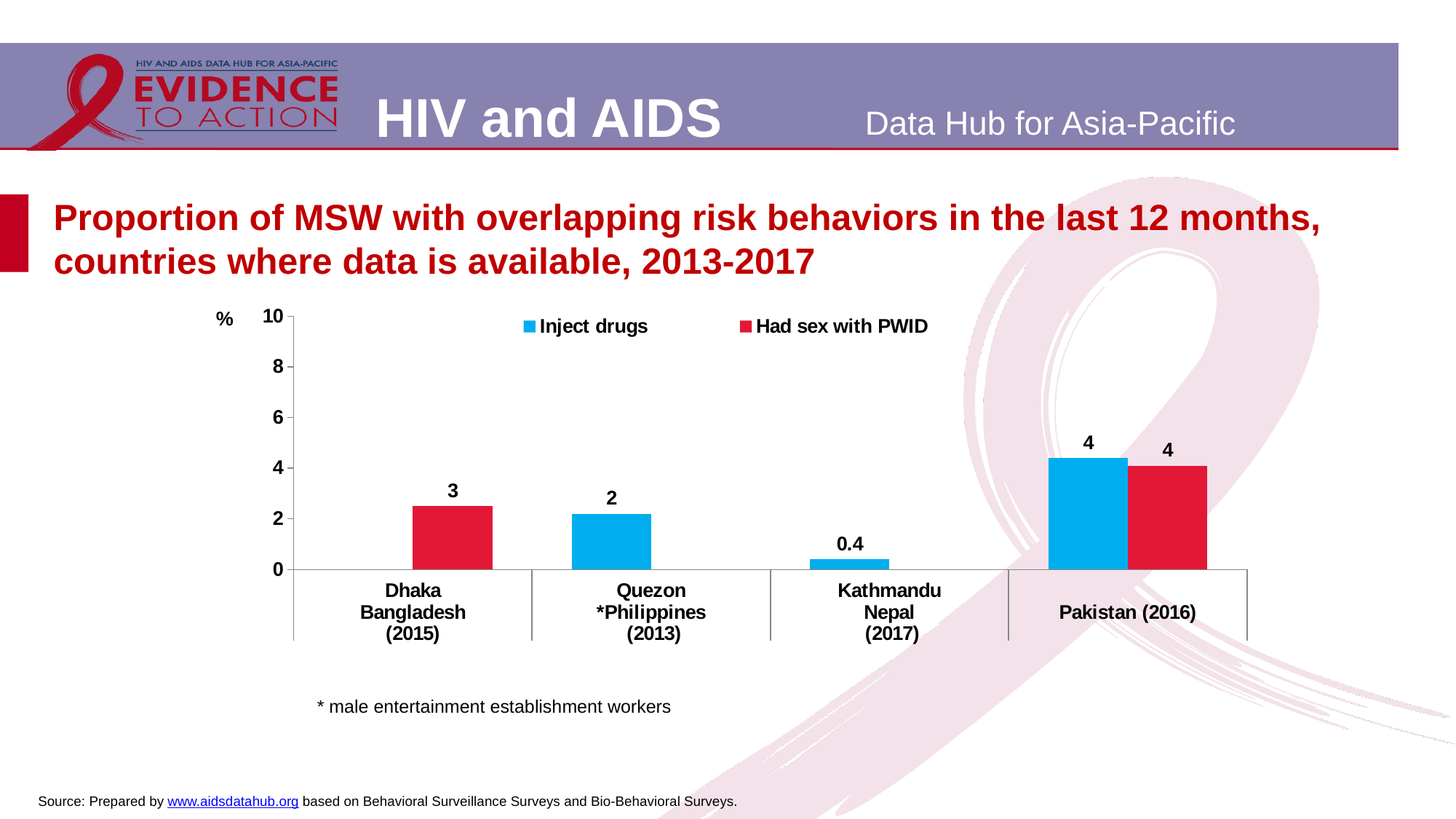
How many series does the legend list? 2 What is the value for Had sex with PWID in Dhaka, Bangladesh (2015)? 3 What is the value for Inject drugs in Pakistan (2016)? 4 What is the value for Had sex with PWID in Pakistan (2016)? 4 What is the value for Inject drugs in Kathmandu, Nepal (2017)? 0.4 What kind of chart is shown on the slide? bar chart What is the difference between the Inject drugs values for Quezon, Philippines (2013) and Kathmandu, Nepal (2017)? 1.6 Which has a larger Inject drugs value: Quezon, Philippines (2013) or Kathmandu, Nepal (2017)? Quezon, Philippines (2013) What is the value for Inject drugs in Quezon, Philippines (2013)? 2 Which location has the highest value for Inject drugs? Pakistan (2016) How many locations are shown on the x axis of the chart? 4